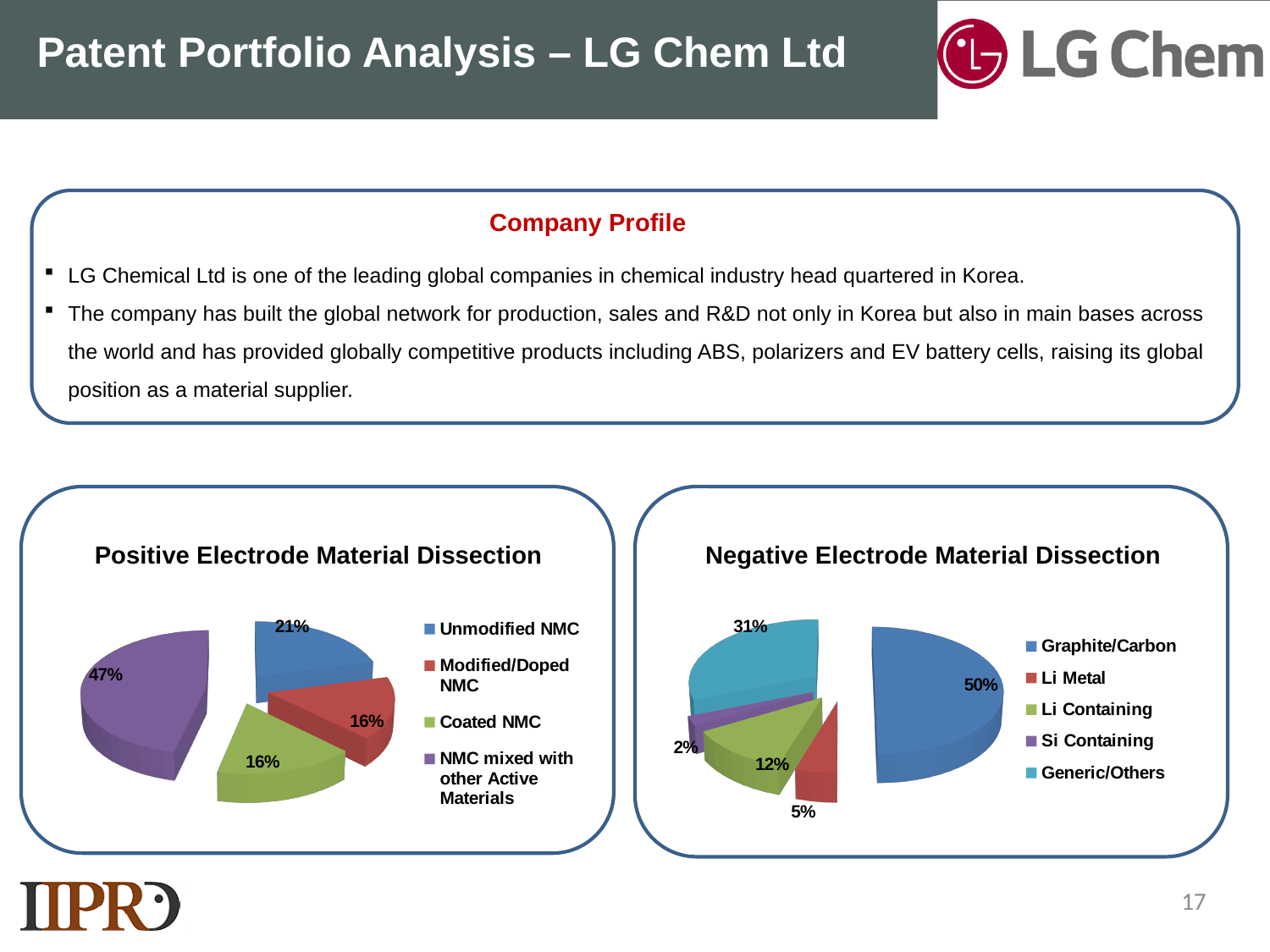
In the Positive Electrode Material Dissection chart, what is the difference between the shares of NMC mixed with other Active Materials and Unmodified NMC? 26% In the Negative Electrode Material Dissection chart, what share does Generic/Others have? 31% In the Positive Electrode Material Dissection chart, what share does NMC mixed with other Active Materials have? 47% In the Negative Electrode Material Dissection chart, what colour is the Generic/Others slice? Teal (light blue) In the Negative Electrode Material Dissection chart, how many categories does the legend list? 5 In the Positive Electrode Material Dissection chart, how many categories does the legend list? 4 What kind of chart is the Positive Electrode Material Dissection chart? Pie chart In the Negative Electrode Material Dissection chart, what share does Graphite/Carbon have? 50% In the Negative Electrode Material Dissection chart, which category has the smallest share? Si Containing In the Positive Electrode Material Dissection chart, which category has the largest share? NMC mixed with other Active Materials In the Negative Electrode Material Dissection chart, which is larger, Li Metal or Li Containing? Li Containing